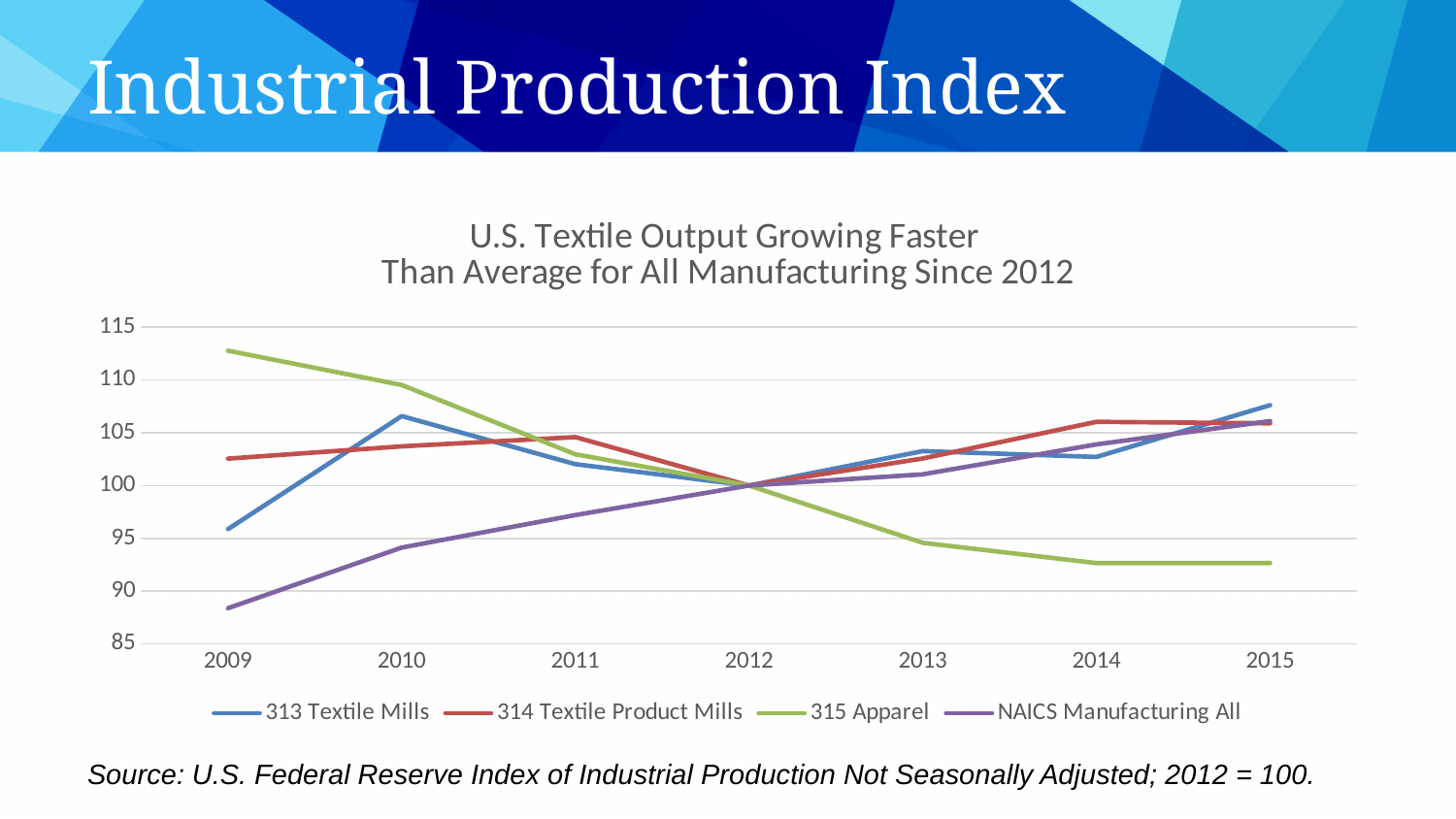
Which series has the highest value in 2009? 315 Apparel What is the title of the chart? U.S. Textile Output Growing Faster Than Average for All Manufacturing Since 2012 Is the value for 313 Textile Mills in 2015 greater or less than 105? greater How many years are shown along the x axis? 7 Is the value for NAICS Manufacturing All in 2009 greater or less than 90? less What is the value of 315 Apparel in 2012? 100 Is the value for 315 Apparel in 2009 greater or less than 110? greater What kind of chart is shown on the slide? line chart Does the 315 Apparel line rise or fall from 2009 to 2015? fall Which series has the lowest value in 2009? NAICS Manufacturing All Which series has the lowest value in 2015? 315 Apparel How many series does the legend list? 4